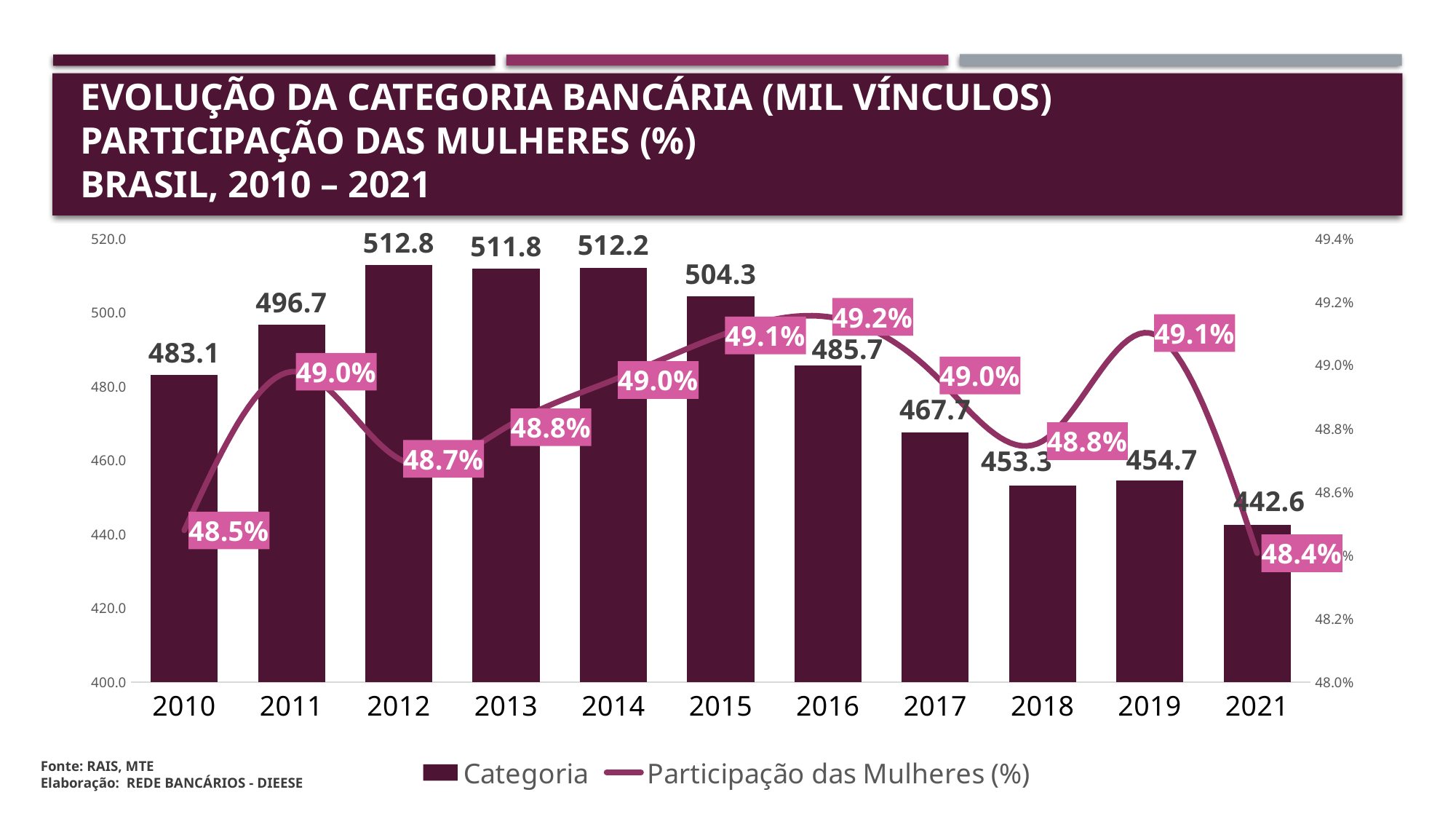
What is the Categoria value for 2018? 453.3 How many series does the legend list? 2 What is the Participação das Mulheres (%) value for 2016? 49.2% Which year has the highest Categoria value? 2012 What is the difference between the Categoria values for 2012 and 2021? 70.2 Which year has the lowest Participação das Mulheres (%) value? 2021 What is the Categoria value for 2012? 512.8 How many years are shown on the x axis? 11 Does the Categoria value rise or fall from 2015 to 2018? fall Which year has the lowest Categoria value? 2021 What is the Participação das Mulheres (%) value for 2010? 48.5% Which year has the larger Categoria value, 2010 or 2016? 2016